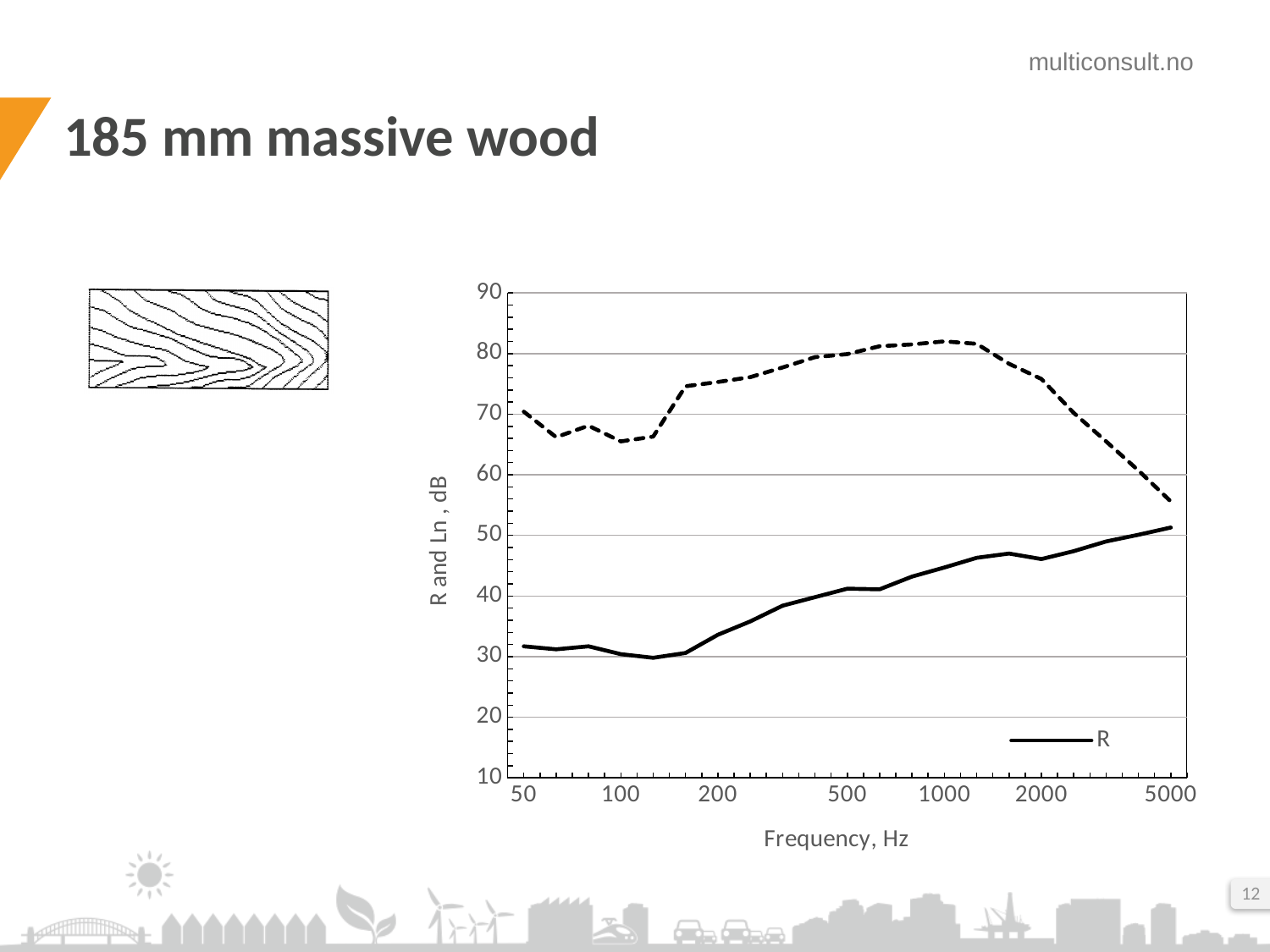
How many series does the chart's legend list? 1 What kind of chart is shown on the slide? line chart Is the value of the dashed line at 500 Hz greater or less than 70? greater Is the value of the solid R line at 1000 Hz greater or less than 50? less What is the title of the y axis of the chart? R and Ln , dB Does the solid R line rise or fall between 200 Hz and 5000 Hz? rise Is the value of the dashed line at 100 Hz greater or less than 70? less What is the title of the x axis of the chart? Frequency, Hz At 1000 Hz, which line has the higher value, the solid R line or the dashed line? the dashed line